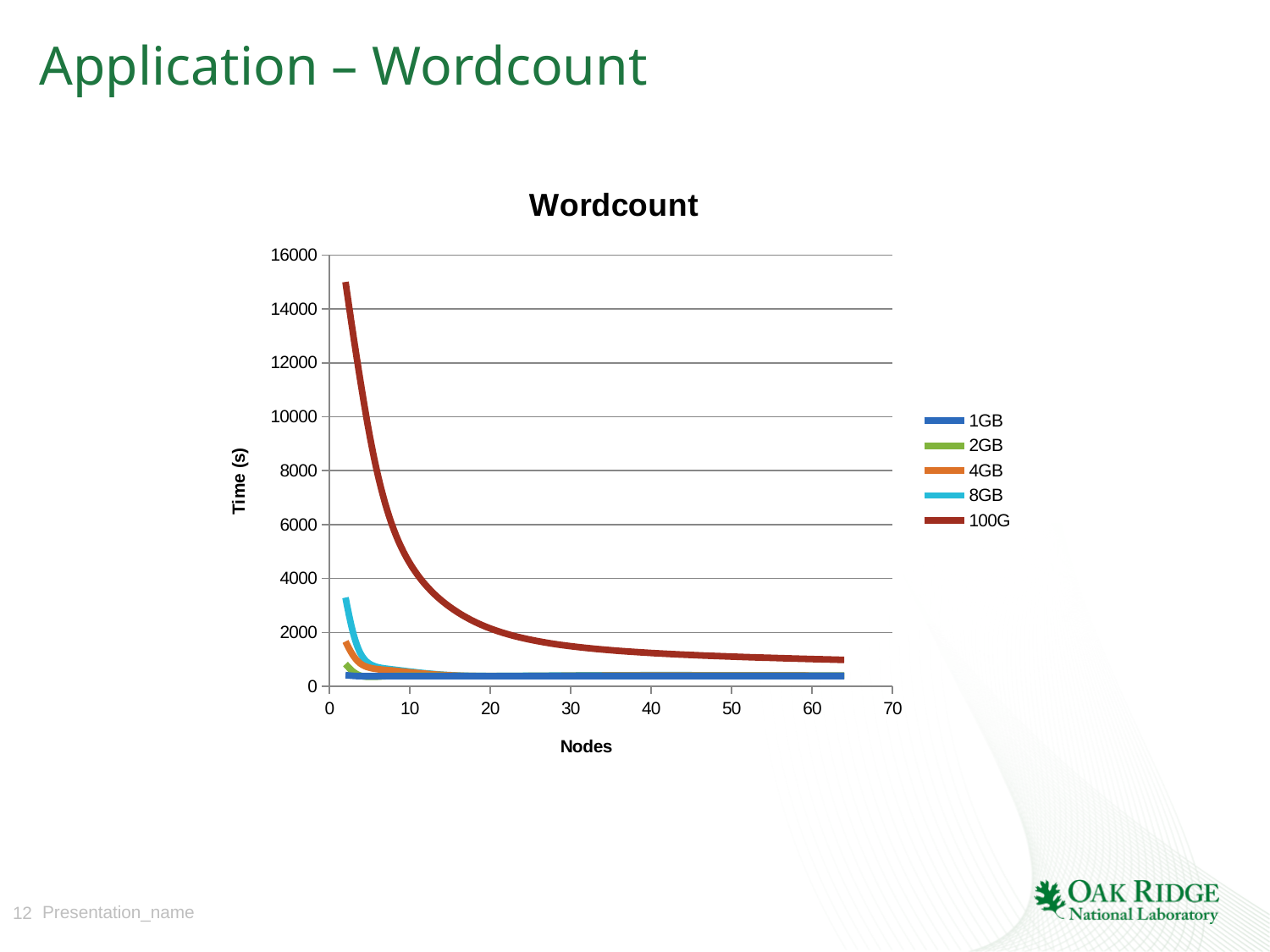
At the smallest number of nodes, which series has the larger time, 8GB or 4GB? 8GB Does the time for the 100G series rise or fall as the number of nodes increases? fall What kind of chart is shown on the slide? line chart Which series has the lowest time at the smallest number of nodes? 1GB What is the title of the chart? Wordcount Does the time for the 8GB series rise or fall as the number of nodes increases? fall Is the starting value for the 100G series greater or less than 14000? greater Is the value for the 100G series at about 60 nodes greater or less than 2000? less What is the label of the y axis? Time (s) Is the starting value for the 8GB series greater or less than 4000? less How many series does the legend list? 5 Which series has the highest time at the smallest number of nodes? 100G